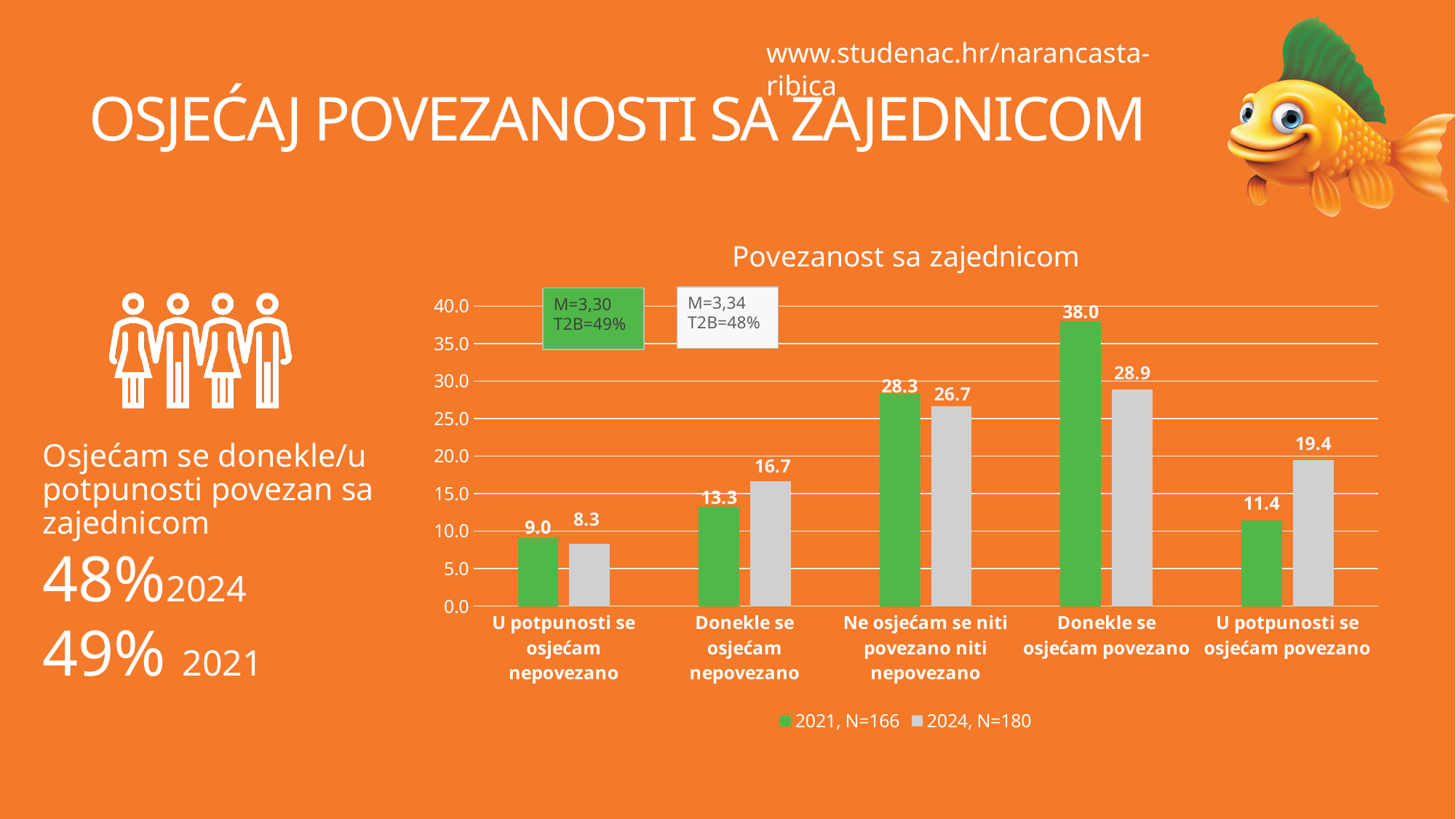
What is the value for 'U potpunosti se osjećam povezano' in the 2024, N=180 series? 19.4 For 'Donekle se osjećam nepovezano', which series has the larger value, 2021 or 2024? 2024, N=180 What is the title of the chart? Povezanost sa zajednicom Is the 2021 value for 'Ne osjećam se niti povezano niti nepovezano' greater or less than 25.0? greater How many series does the legend list? 2 What is the value for 'Donekle se osjećam povezano' in the 2021, N=166 series? 38.0 What is the difference between the 2021 and 2024 values for 'Donekle se osjećam povezano'? 9.1 How many categories are shown on the x axis of the chart? 5 What kind of chart is shown on the slide? bar chart Which category has the highest value in the 2021, N=166 series? Donekle se osjećam povezano Which category has the lowest value in the 2024, N=180 series? U potpunosti se osjećam nepovezano What is the value for 'Ne osjećam se niti povezano niti nepovezano' in the 2024, N=180 series? 26.7